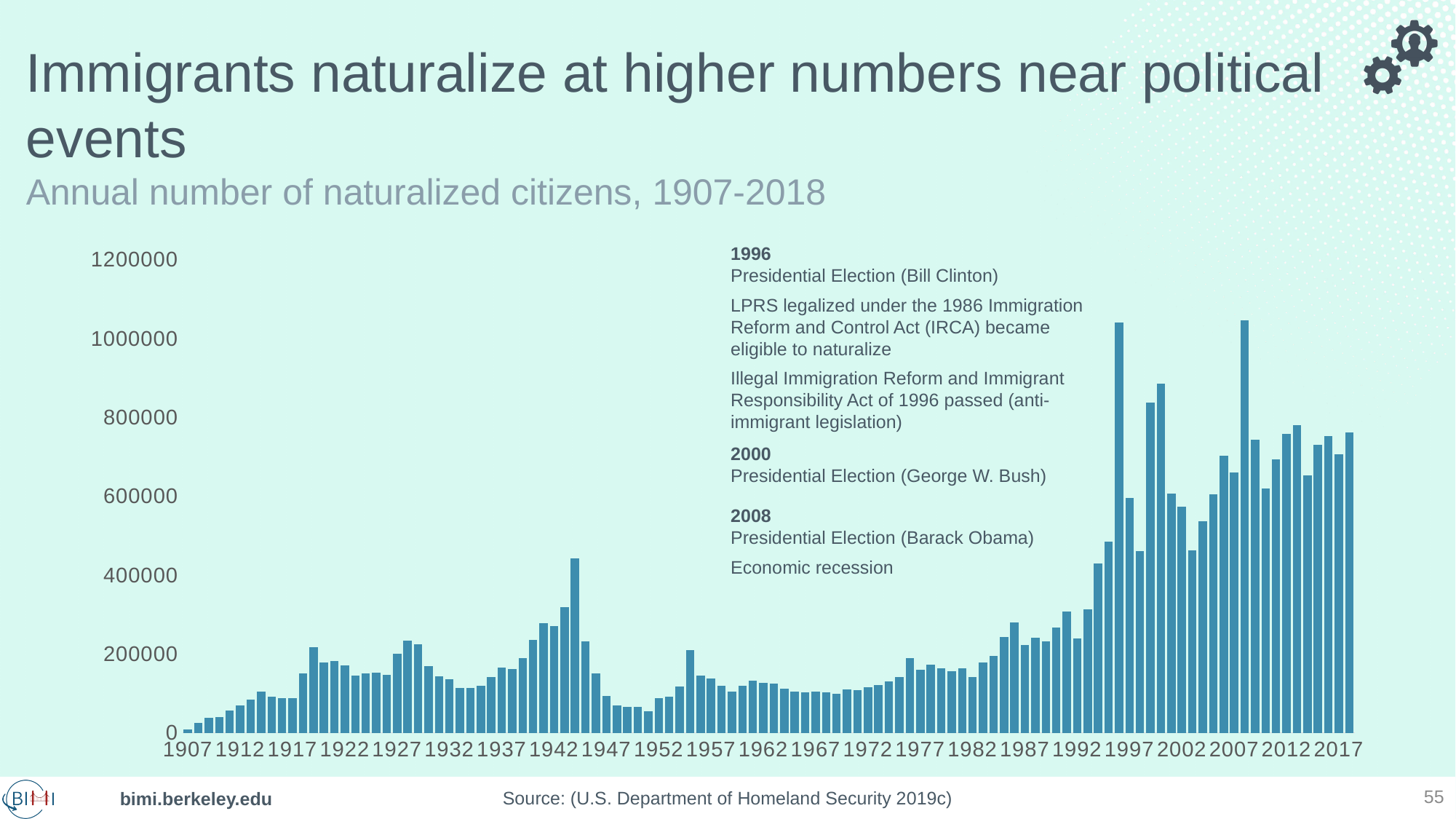
Is the value for 2012 greater or less than 600000? greater Which year has the larger number of naturalized citizens, 1996 or 1957? 1996 Is the value for 1992 greater or less than 200000? greater What kind of chart is shown on the slide? Bar chart Is the value for 1967 greater or less than 200000? less Do the values generally rise or fall between 1982 and 1996? rise Which year has the lowest number of naturalized citizens in the chart? 1907 According to the chart annotation, which presidential election is associated with 2000? George W. Bush What is the subtitle describing the chart's data? Annual number of naturalized citizens, 1907-2018